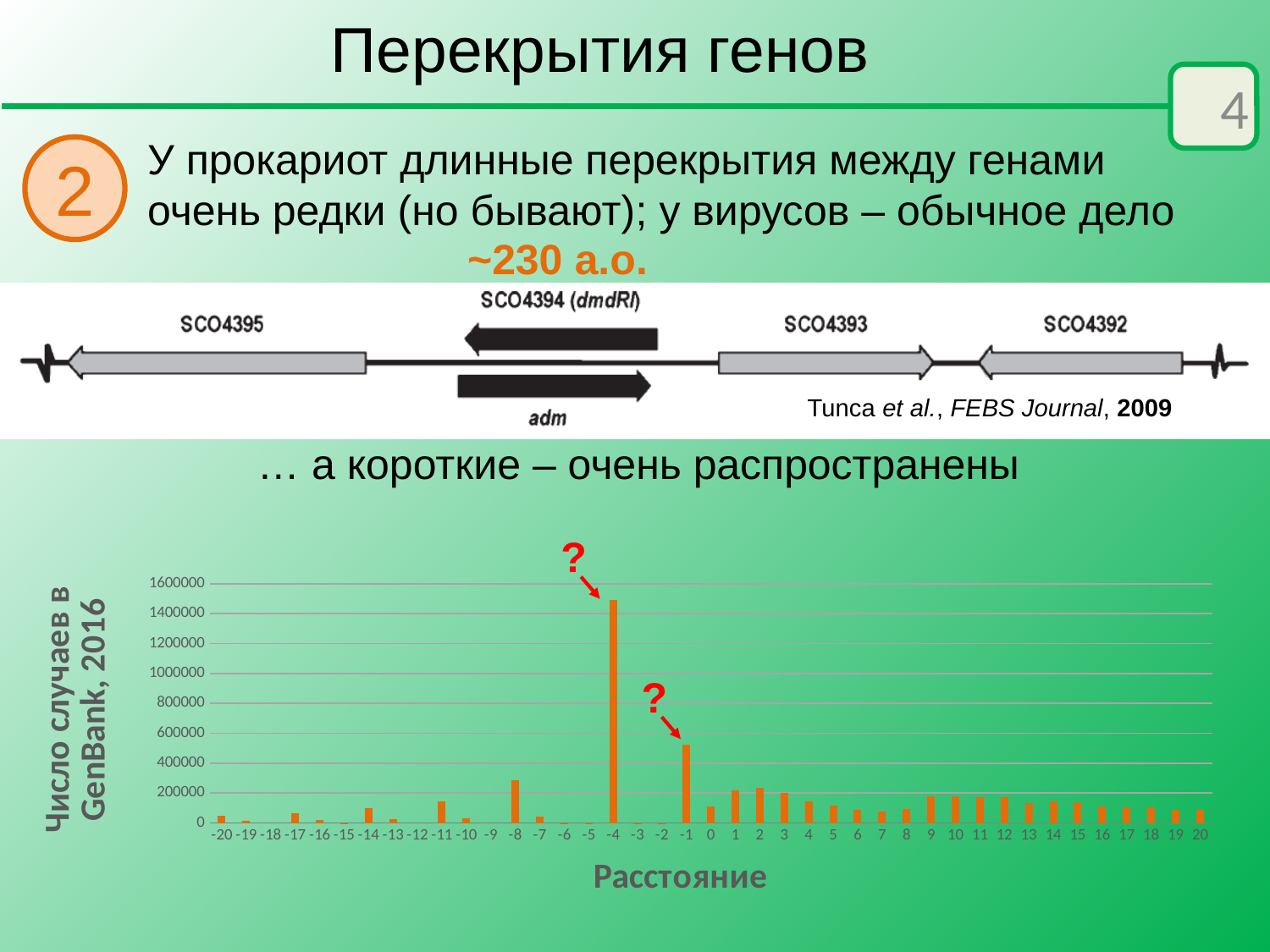
What is the title of the y axis of the chart? Число случаев в GenBank, 2016 Which distance value has the highest bar in the chart? -4 Which has the larger value, distance -8 or distance -7? -8 How many distance categories are shown on the x axis of the chart? 41 Which has the larger value, distance -4 or distance -1? -4 Is the value for distance -1 greater or less than 600000? less Is the value for distance -8 greater or less than 200000? greater Is the value for distance -1 greater or less than 400000? greater What is the title of the x axis of the chart? Расстояние What kind of chart is shown at the bottom of the slide? bar chart